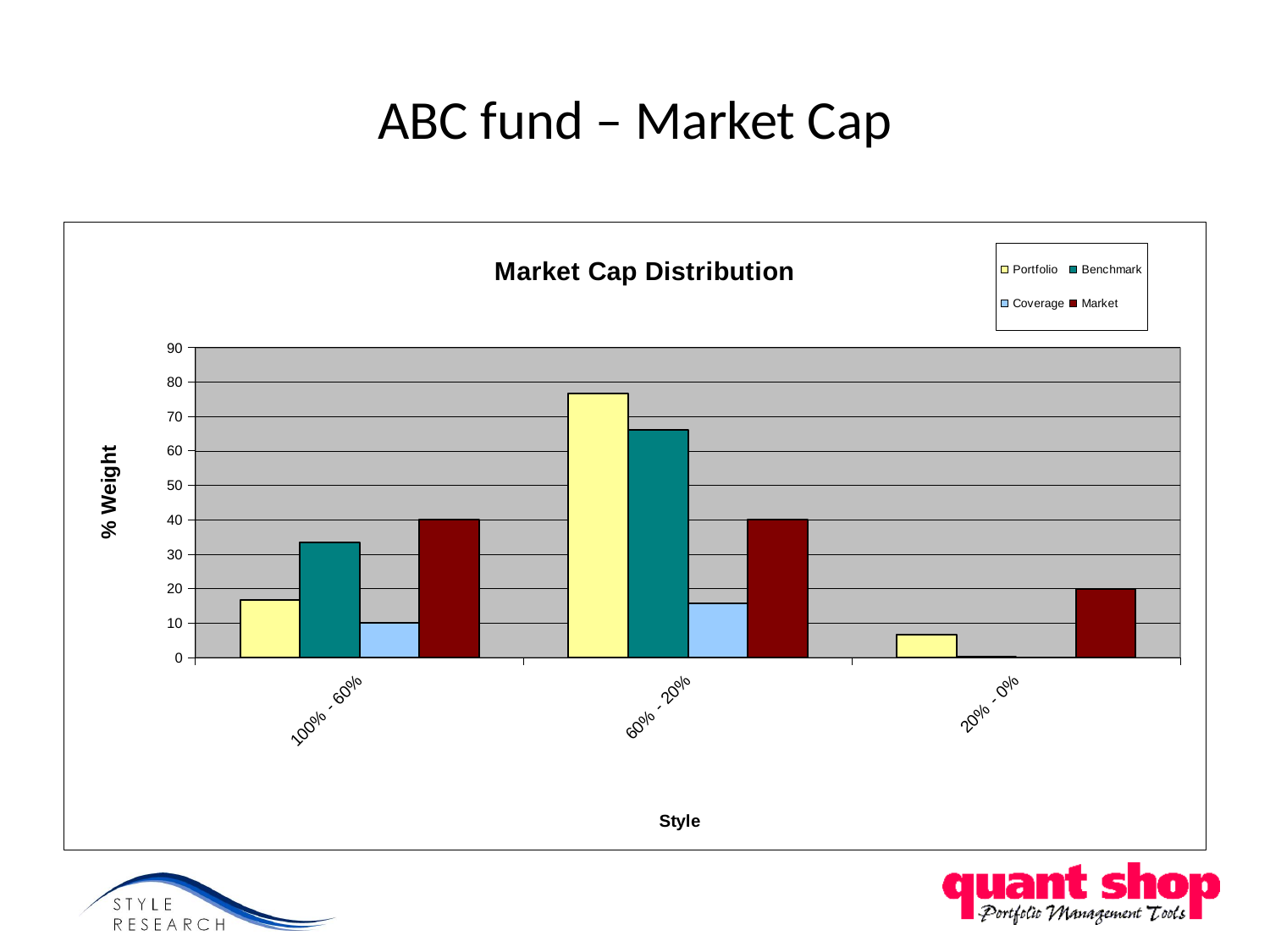
In which category is the Portfolio bar lowest? 20% - 0% What is the Market value for the 20% - 0% category? 20 In the 60% - 20% category, which is larger, Portfolio or Benchmark? Portfolio What kind of chart is the Market Cap Distribution chart? bar chart In the 100% - 60% category, which is larger, Portfolio or Benchmark? Benchmark Is the Coverage value for 60% - 20% greater or less than 20? less How many categories are shown on the x axis of the Market Cap Distribution chart? 3 Is the Benchmark value for 100% - 60% greater or less than 30? greater Is the Portfolio value for 60% - 20% greater or less than 70? greater What is the title of the y axis on the Market Cap Distribution chart? % Weight In which category is the Portfolio bar highest? 60% - 20% How many series does the legend of the Market Cap Distribution chart list? 4